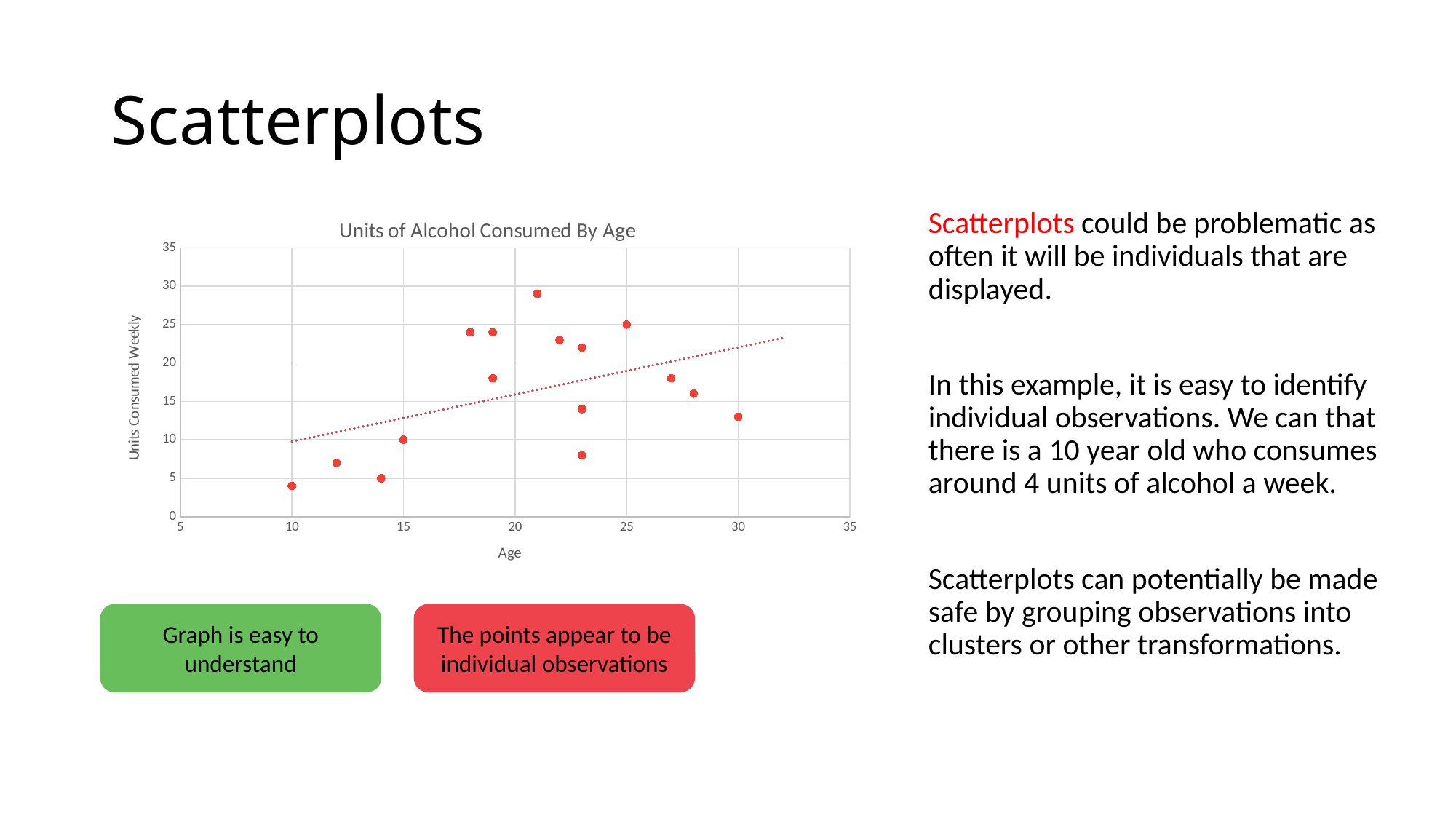
What is the label of the y axis? Units Consumed Weekly Which age has the highest number of units consumed weekly? 21 Is the value for the point at age 21 greater or less than 25? greater What kind of chart is shown on the slide? Scatter plot Is the value for the point at age 10 greater or less than 5? less Which has a higher value, the point at age 21 or the point at age 30? Age 21 Does the dotted trend line rise or fall as age increases? Rises Which age has the lowest number of units consumed weekly? 10 What is the title of the chart? Units of Alcohol Consumed By Age Is the value for the point at age 30 greater or less than 15? less How many data points are plotted on the chart? 16 Which has a higher value, the point at age 10 or the point at age 15? Age 15